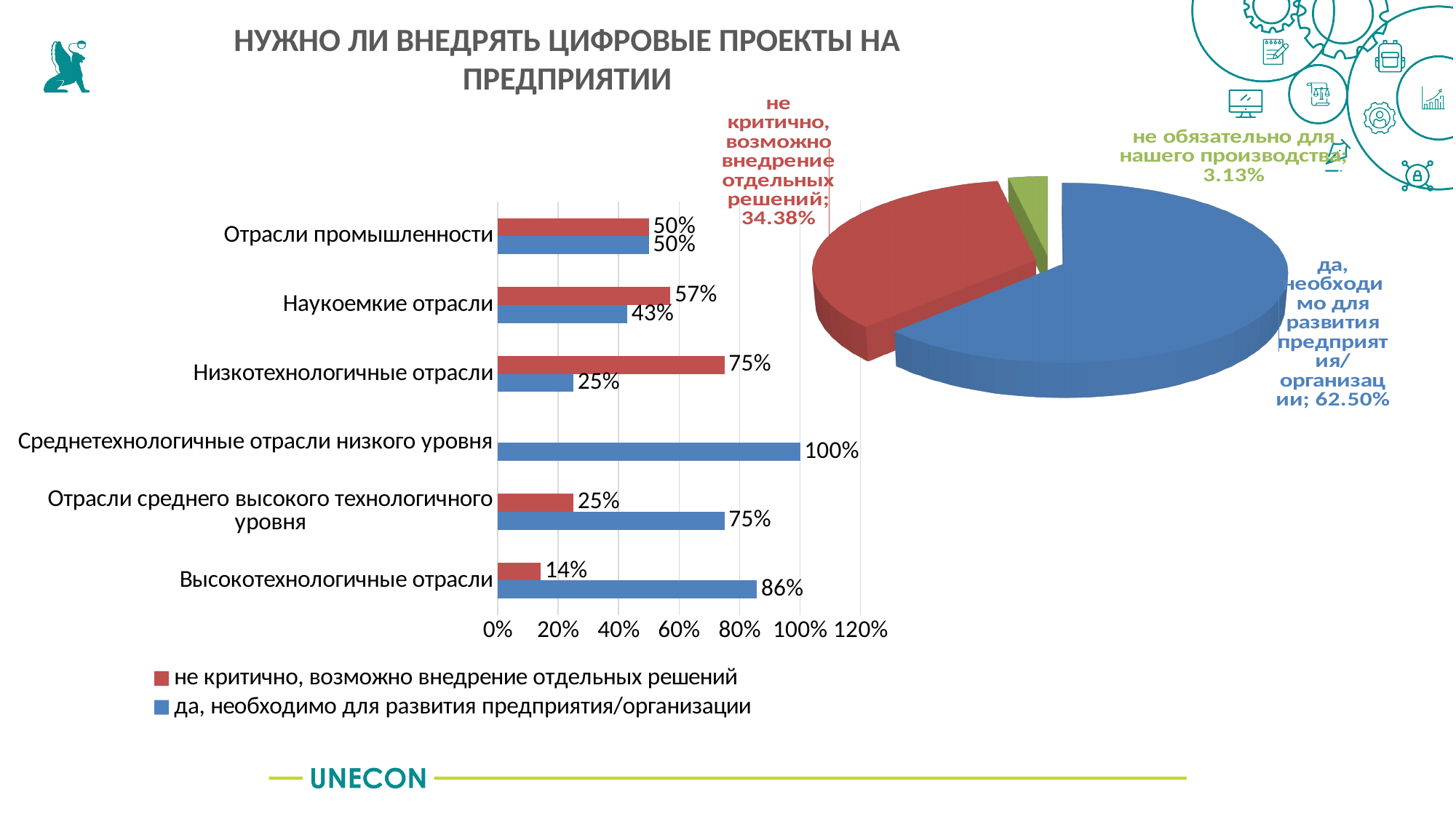
In the pie chart on the right, which slice is the smallest? не обязательно для нашего производства In the bar chart on the left, what is the difference between the two series for Наукоемкие отрасли? 14% In the bar chart on the left, which category has the lowest value for 'не критично, возможно внедрение отдельных решений' among those with a red bar? Высокотехнологичные отрасли In the bar chart on the left, what is the value of 'да, необходимо для развития предприятия/организации' for Высокотехнологичные отрасли? 86% In the bar chart on the left, what is the value of 'не критично, возможно внедрение отдельных решений' for Низкотехнологичные отрасли? 75% What type of chart is shown on the left of the slide? Bar chart In the bar chart on the left, for Отрасли среднего высокого технологичного уровня, which series has the larger value? да, необходимо для развития предприятия/организации How many series does the legend of the bar chart on the left list? 2 In the pie chart on the right, what share does 'да, необходимо для развития предприятия/организации' have? 62.50% How many categories are shown in the bar chart on the left? 6 In the bar chart on the left, which category has the highest value for 'да, необходимо для развития предприятия/организации'? Среднетехнологичные отрасли низкого уровня In the pie chart on the right, what is the difference between the 'не критично, возможно внедрение отдельных решений' slice and the 'не обязательно для нашего производства' slice? 31.25%